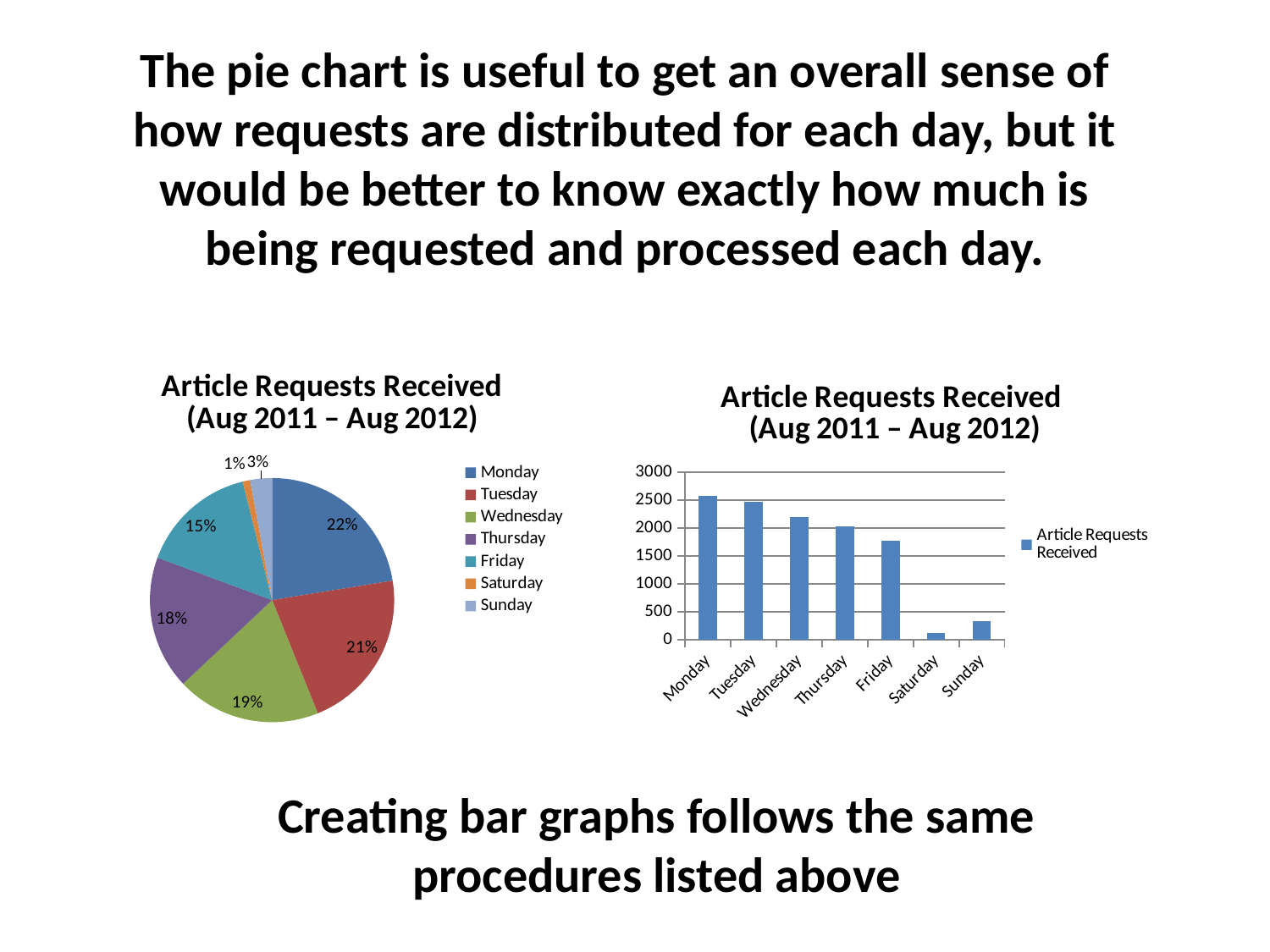
What type of chart is shown on the right side of the slide? Bar chart In the bar chart on the right, which is larger, the value for Wednesday or the value for Thursday? Wednesday In the pie chart on the left, which day has the largest share of article requests? Monday In the pie chart on the left, which day has the smallest share of article requests? Saturday In the pie chart on the left, what share of article requests was received on Friday? 15% In the bar chart on the right, which day has the lowest number of article requests received? Saturday In the bar chart on the right, is the value for Monday greater or less than 2500? greater In the bar chart on the right, is the value for Friday greater or less than 2000? less In the pie chart on the left, how many percentage points larger is Thursday's share than Sunday's share? 15 In the pie chart on the left, how many slices does the legend list? 7 In the bar chart on the right, is the value for Saturday greater or less than 500? less In the pie chart on the left, what share of article requests was received on Monday? 22%